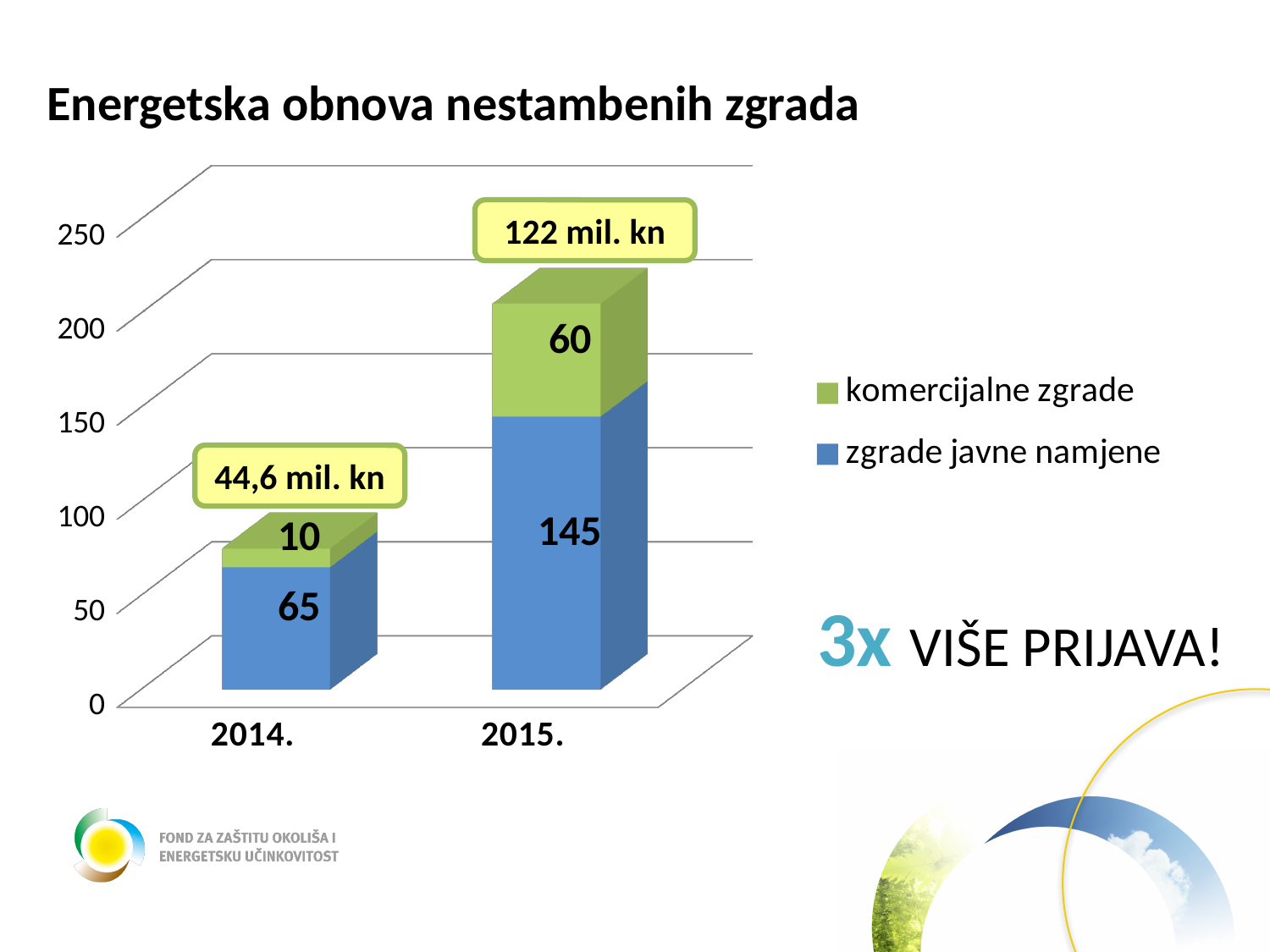
How many series does the legend list? 2 What kind of chart is shown on the slide? Stacked bar chart What amount is shown in the callout above the 2015. bar? 122 mil. kn What is the value for zgrade javne namjene in 2015.? 145 How many categories are shown on the x axis? 2 Which year has the higher value for komercijalne zgrade, 2014. or 2015.? 2015. What is the total of the stacked bar for 2014.? 75 What is the value for zgrade javne namjene in 2014.? 65 What is the value for komercijalne zgrade in 2015.? 60 What is the value for komercijalne zgrade in 2014.? 10 What is the difference between the zgrade javne namjene values for 2015. and 2014.? 80 What is the total of the stacked bar for 2015.? 205